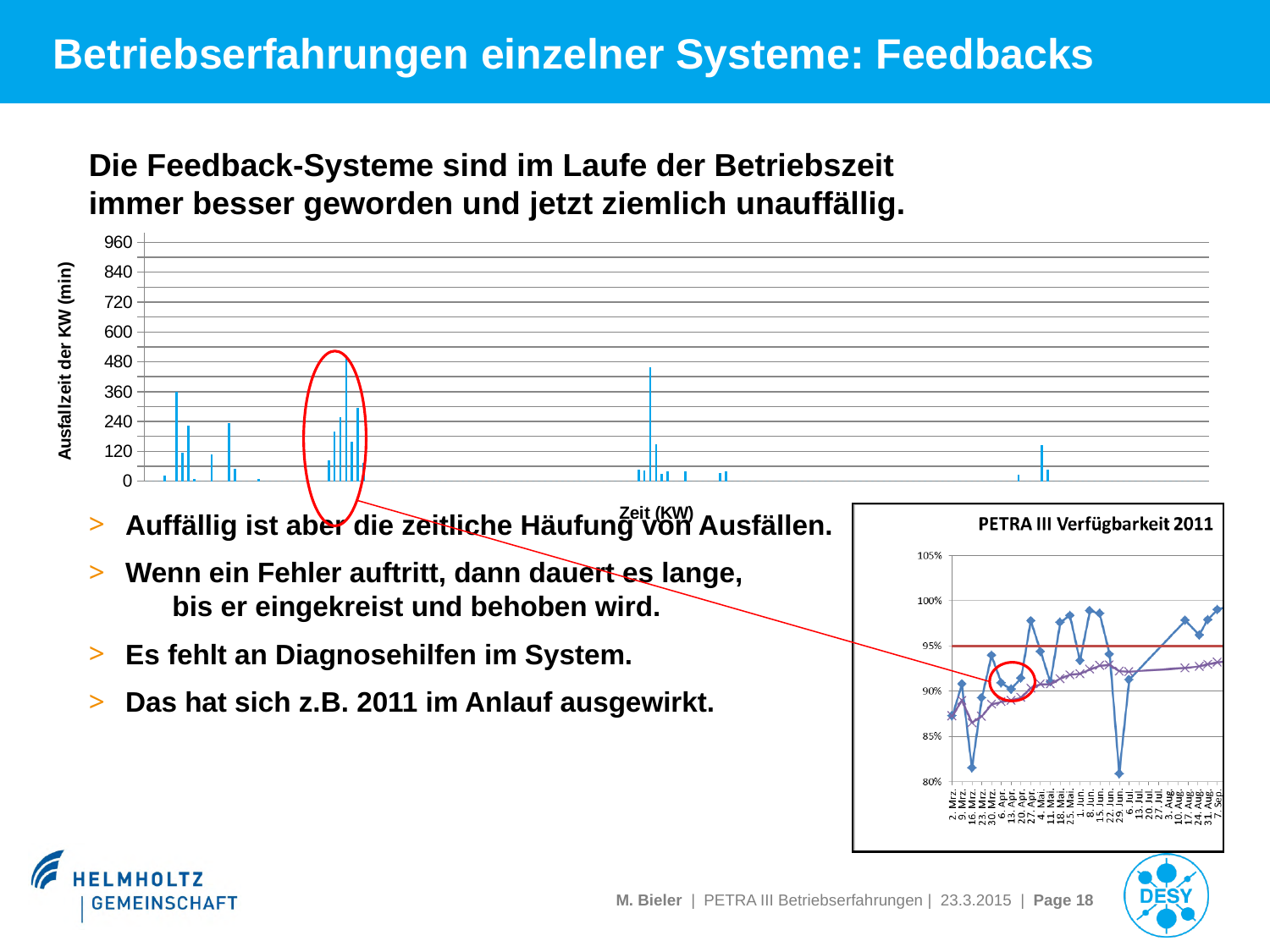
In the PETRA III Verfügbarkeit 2011 chart, is the value of the diamond-marker line at 29. Jun greater or less than 85%? less In the top bar chart, is the tallest bar greater or less than 360? greater What kind of chart is the large chart at the top of the slide (Ausfallzeit der KW)? bar chart In the top bar chart, is the tallest bar greater or less than 600? less What is the highest tick value shown on the y-axis of the top bar chart? 960 What is the y-axis title of the top bar chart? Ausfallzeit der KW (min) In the PETRA III Verfügbarkeit 2011 chart, what is the lowest tick value on the y-axis? 80% What kind of chart is the PETRA III Verfügbarkeit 2011 chart? line chart In the PETRA III Verfügbarkeit 2011 chart, does the line with x markers generally rise or fall from left to right? rise